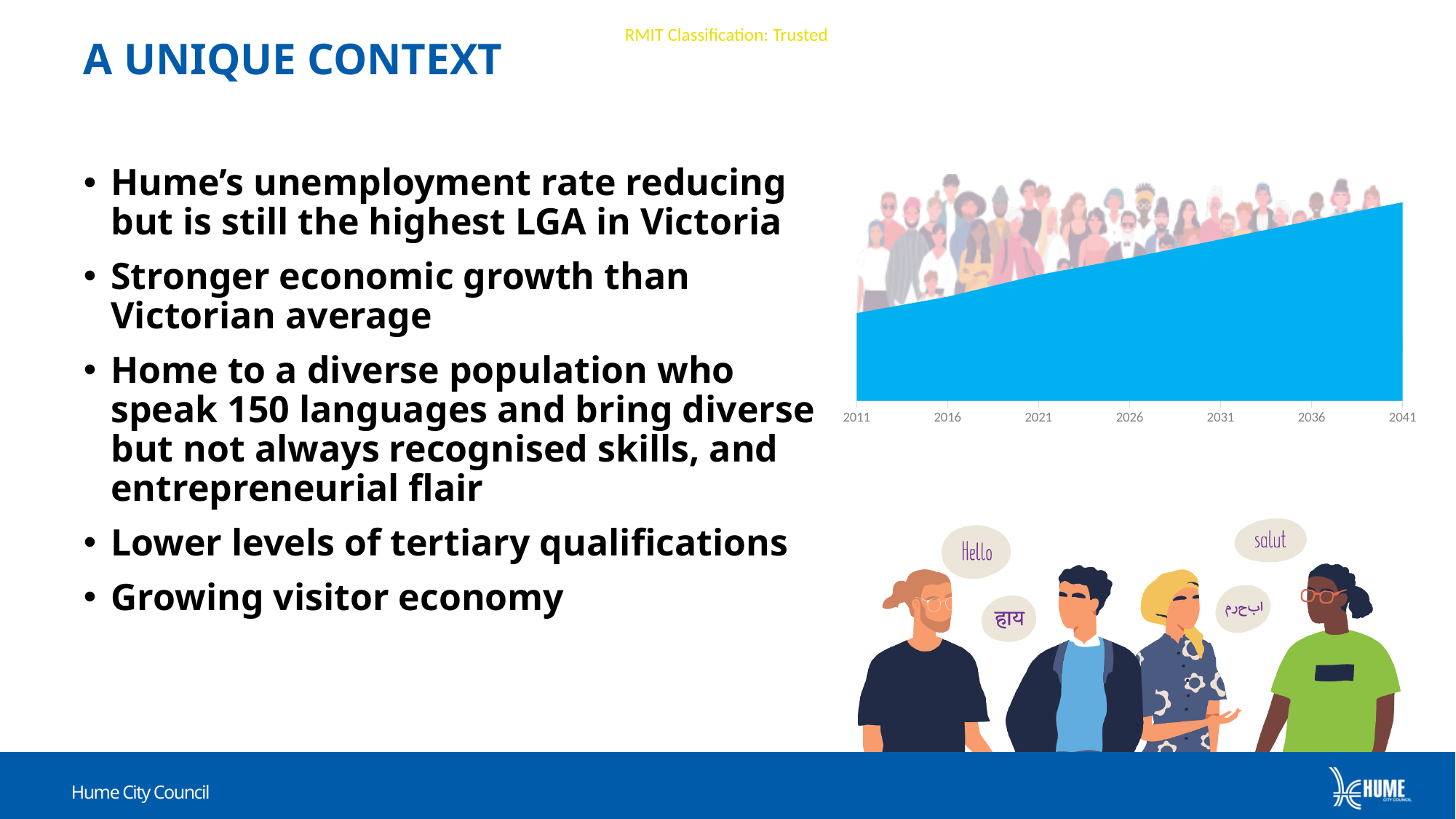
In the area chart, is the value for 2036 larger or smaller than the value for 2016? larger Which year on the x axis of the area chart has the lowest value? 2011 What is the last year shown on the x axis of the area chart? 2041 What is the first year shown on the x axis of the area chart? 2011 What kind of chart is shown on the right of the slide? area chart Which year on the x axis of the area chart has the highest value? 2041 How many year labels are shown on the x axis of the area chart? 7 Do the values in the area chart rise or fall from 2011 to 2041? rise